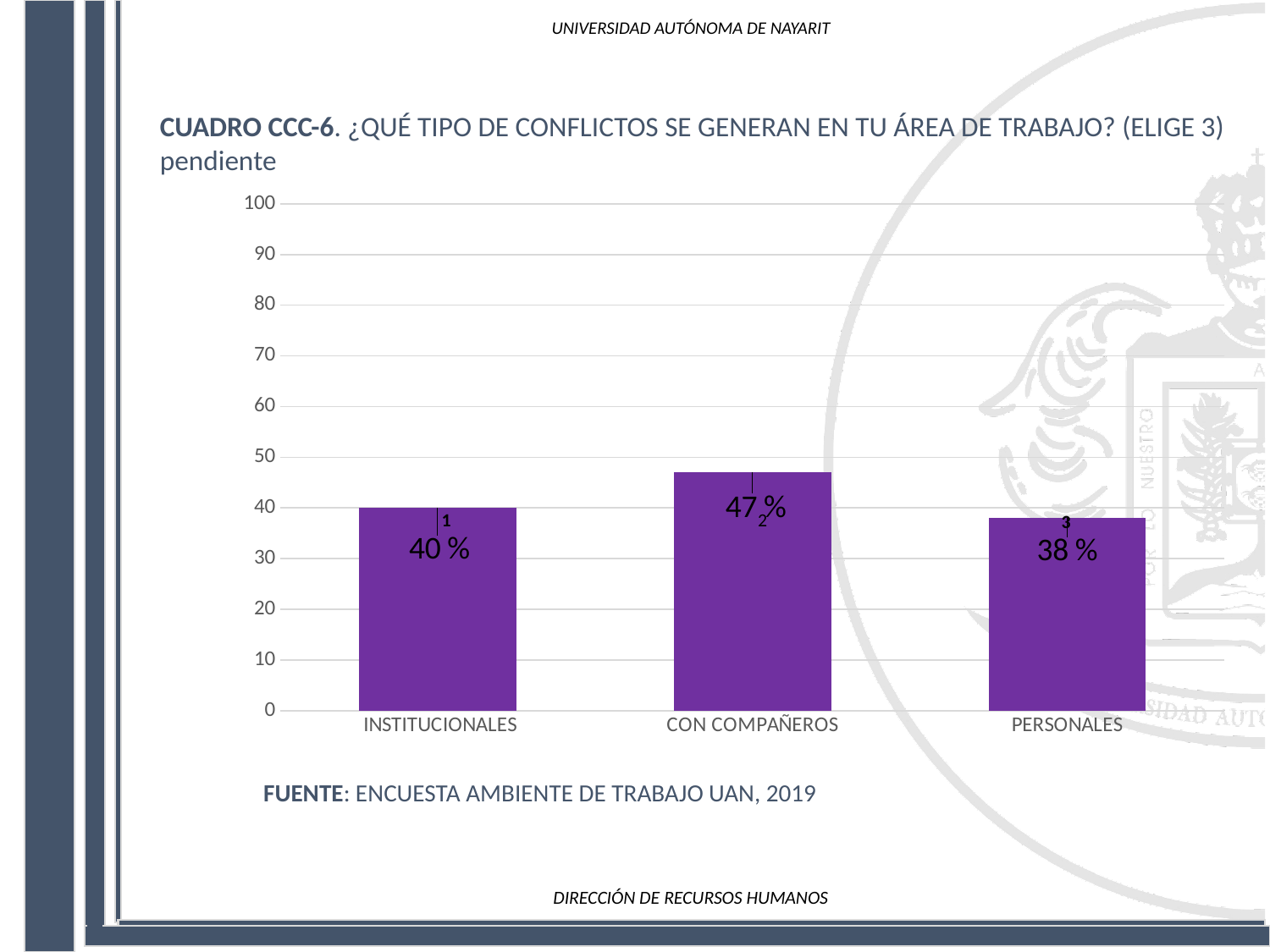
What source is cited below the chart? ENCUESTA AMBIENTE DE TRABAJO UAN, 2019 What kind of chart is shown on the slide? bar chart What is the difference between the values for CON COMPAÑEROS and PERSONALES? 9 % Is the value for CON COMPAÑEROS greater or less than 50? less What is the value for PERSONALES? 38 % Which category has the highest value? CON COMPAÑEROS What is the value for CON COMPAÑEROS? 47 % What is the value for INSTITUCIONALES? 40 % What is the difference between the values for INSTITUCIONALES and PERSONALES? 2 % Which category has the lowest value? PERSONALES Which is larger, the value for INSTITUCIONALES or the value for CON COMPAÑEROS? CON COMPAÑEROS How many categories are shown on the x axis? 3